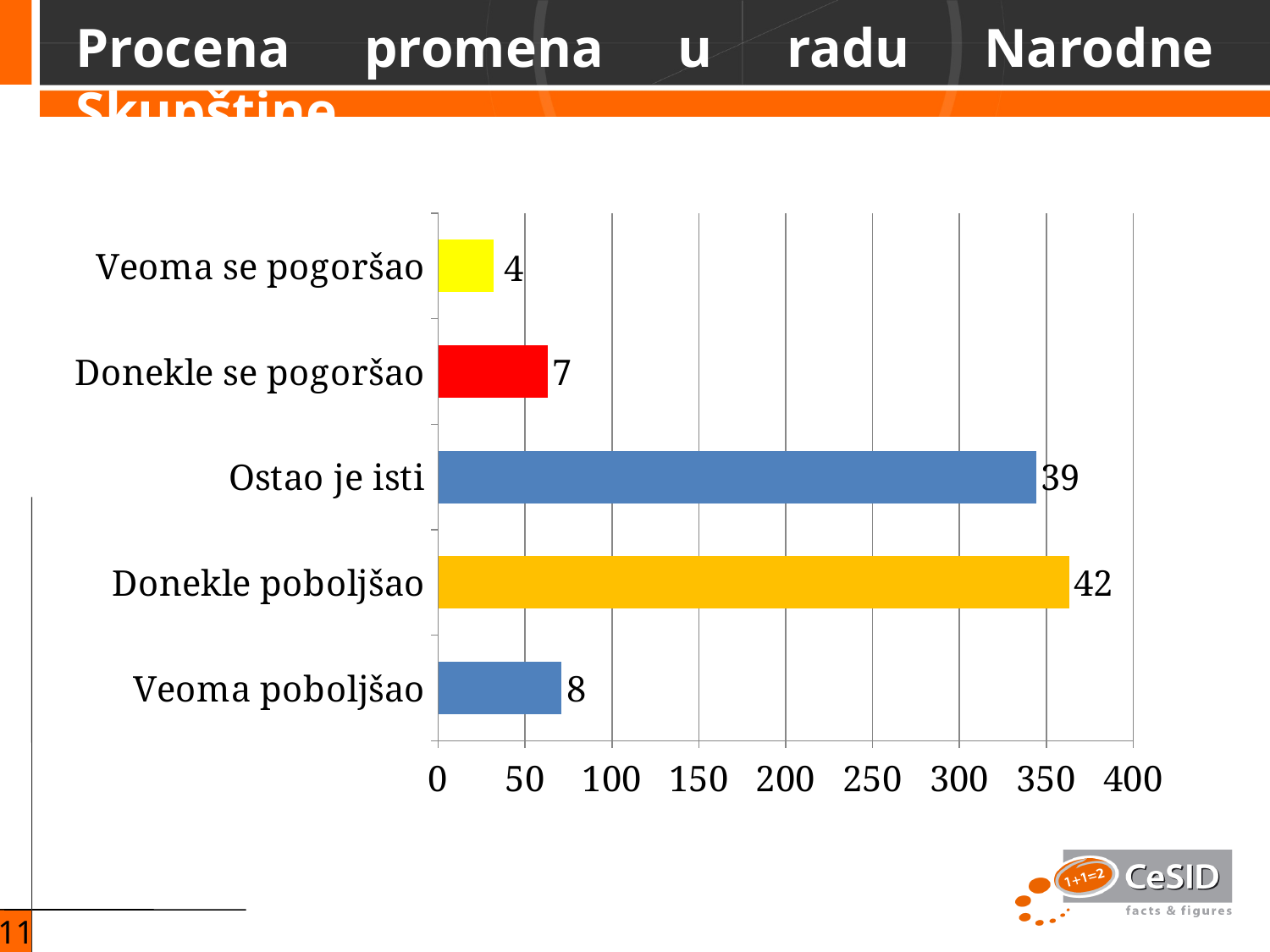
What is the value for "Veoma se pogoršao"? 4 What colour is the bar for "Donekle se pogoršao"? Red What kind of chart is shown on the slide? Bar chart How many categories are shown in the chart? 5 What is the difference between the values for "Donekle poboljšao" and "Ostao je isti"? 3 What is the value for "Veoma poboljšao"? 8 Which is larger, the value for "Veoma poboljšao" or the value for "Donekle se pogoršao"? Veoma poboljšao What is the value for "Donekle se pogoršao"? 7 Which category has the lowest value? Veoma se pogoršao What is the difference between the values for "Ostao je isti" and "Donekle se pogoršao"? 32 Which category has the highest value? Donekle poboljšao What is the value for "Ostao je isti"? 39